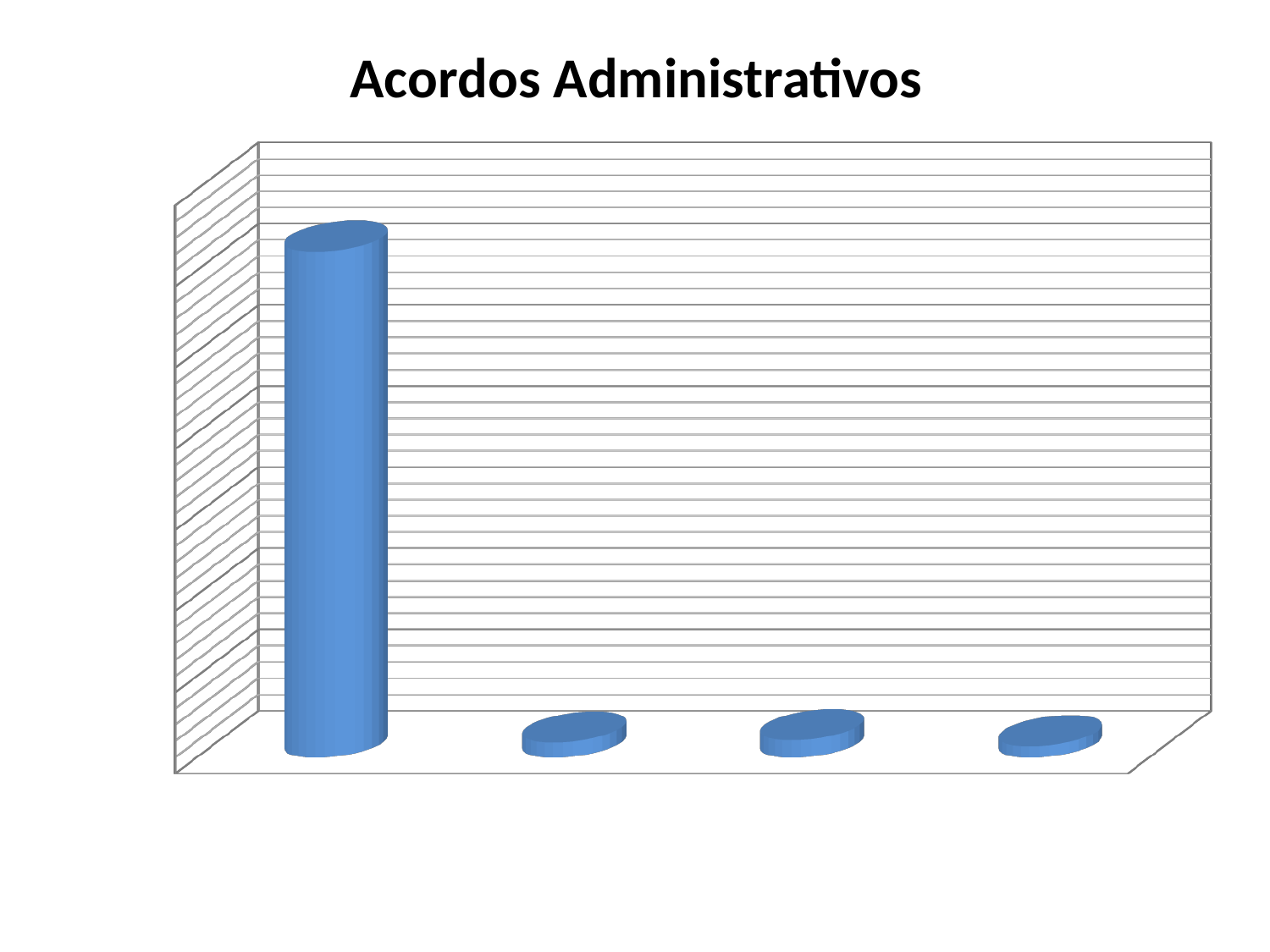
What kind of chart is shown on the slide? bar chart Which bar in the chart is the tallest, by position from the left? the first (leftmost) bar Is the leftmost bar taller or shorter than the second bar from the left? taller What is the title of the chart? Acordos Administrativos What colour are the bars in the chart? blue How many bars are plotted in the chart? 4